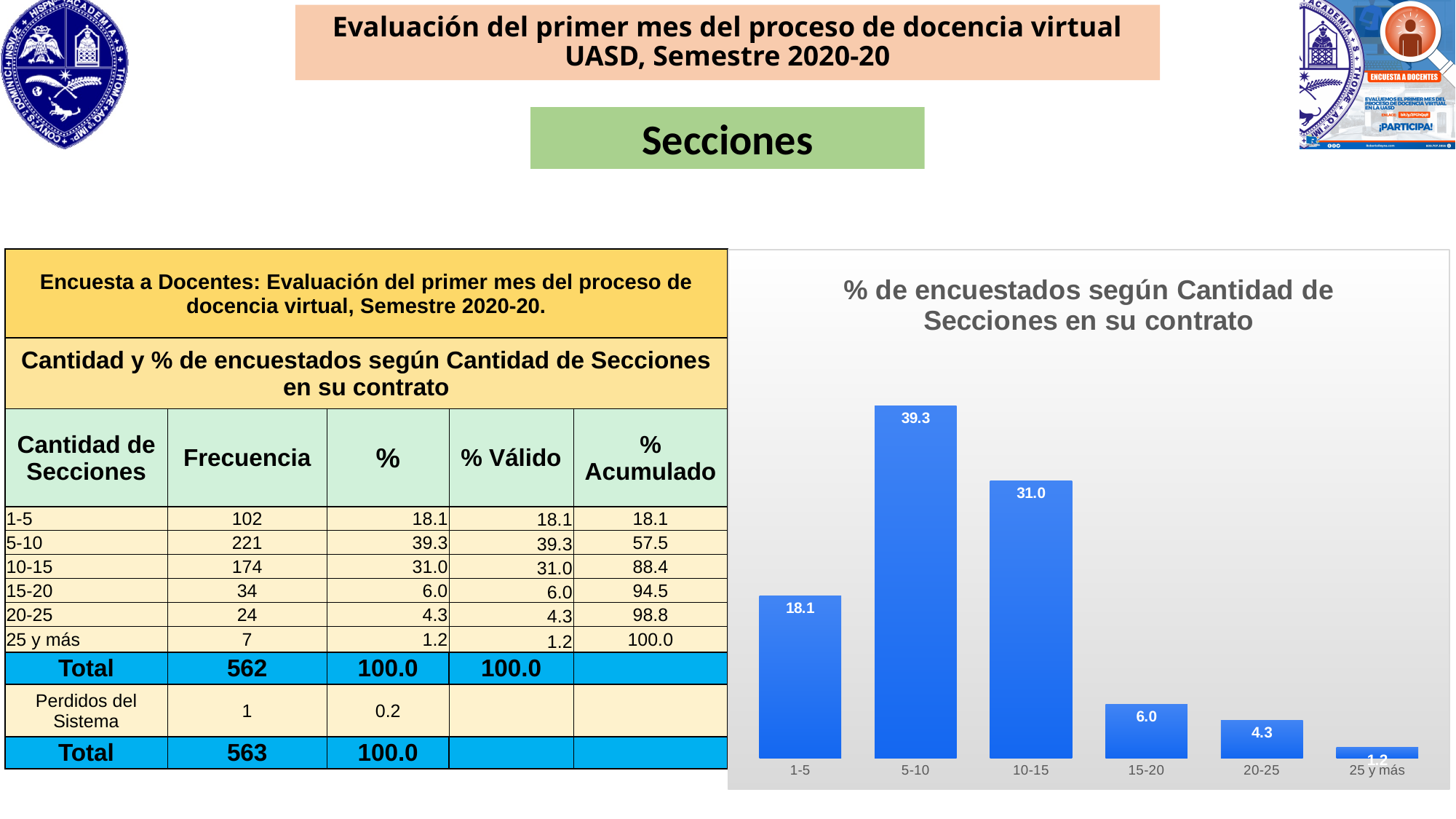
What is the difference between the values for 5-10 and 10-15? 8.3 What is the value for the 10-15 category in the chart? 31.0 What is the value for the 5-10 category in the chart? 39.3 What is the title of the chart? % de encuestados según Cantidad de Secciones en su contrato Which category has the highest value in the chart? 5-10 Which category has the lowest value in the chart? 25 y más What is the value for the 1-5 category in the chart? 18.1 What kind of chart is shown on the slide? bar chart What is the value for the 20-25 category in the chart? 4.3 Which is larger, the value for 15-20 or the value for 20-25? 15-20 How many categories are shown on the x axis of the chart? 6 What is the difference between the values for 1-5 and 15-20? 12.1